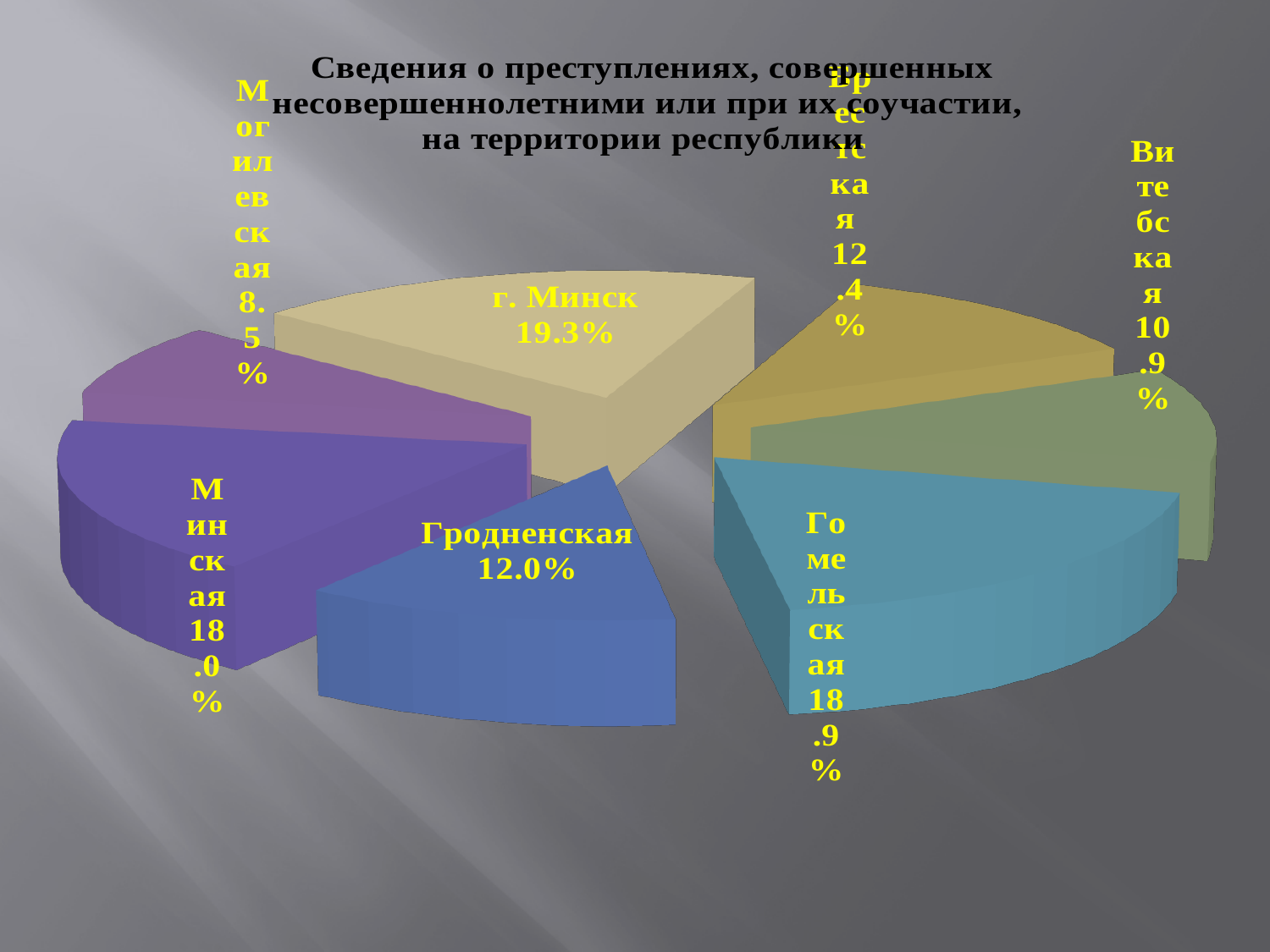
Which region has the smallest share of the pie? Могилевская What is the title of the chart? Сведения о преступлениях, совершенных несовершеннолетними или при их соучастии, на территории республики Which has the larger share, Гродненская or Витебская? Гродненская What is the difference between the shares of Гомельская and Минская? 0.9% Which region has the largest share of the pie? г. Минск What is the value shown for Гомельская? 18.9% What kind of chart is shown on the slide? Pie chart What is the value shown for Гродненская? 12.0% How many slices does the pie chart have? 7 What is the value shown for Минская? 18.0% What share of the pie does г. Минск account for? 19.3% What is the value shown for Витебская? 10.9%